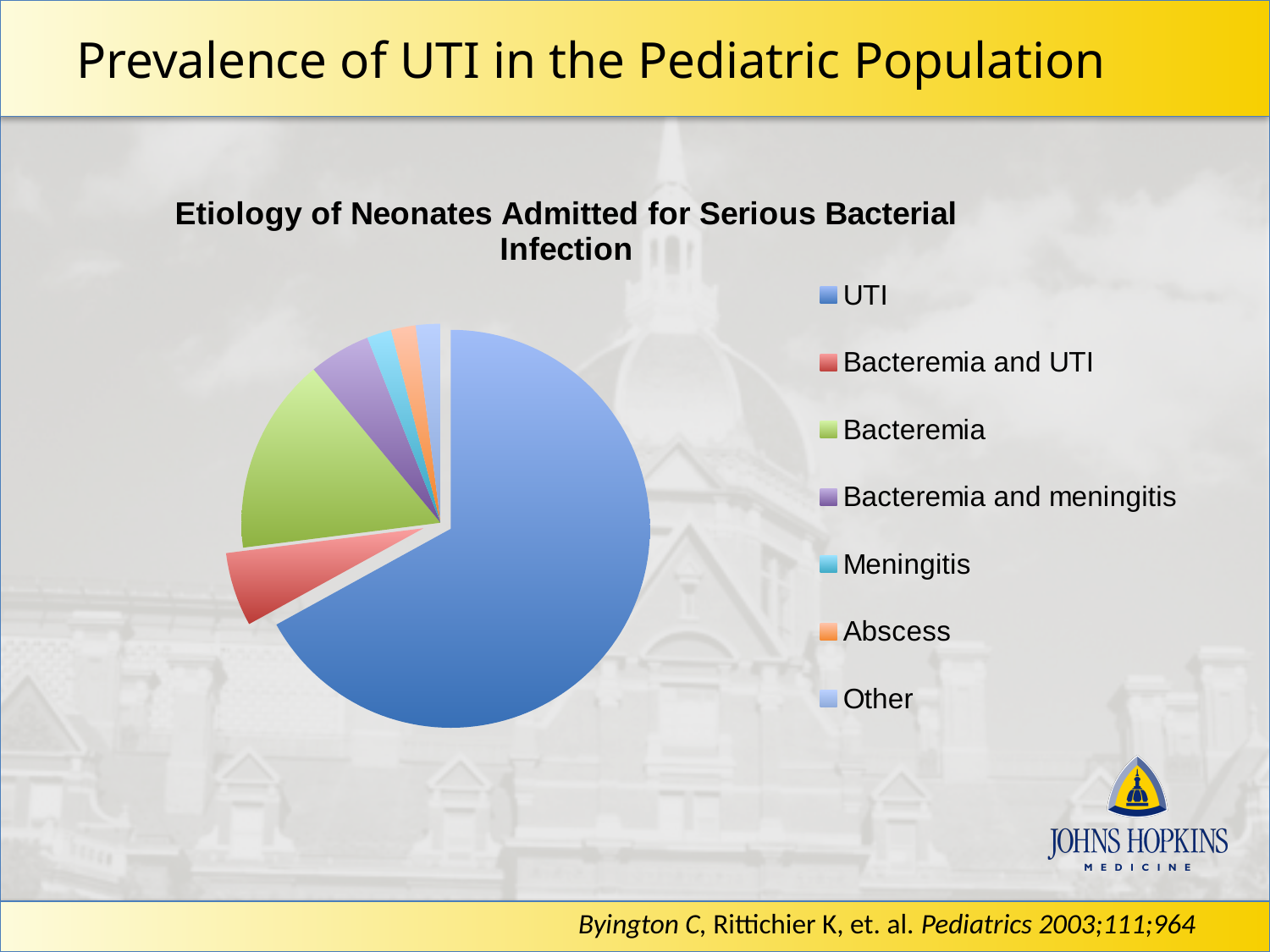
Which category has the largest slice of the pie? UTI What kind of chart is shown on the slide? pie chart Which is larger, the slice for Bacteremia or the slice for Bacteremia and UTI? Bacteremia What is the title of the chart? Etiology of Neonates Admitted for Serious Bacterial Infection Which is larger, the slice for UTI or the slice for Bacteremia? UTI How many entries does the legend list? 7 Which is larger, the slice for Bacteremia or the slice for Bacteremia and meningitis? Bacteremia Is the share of the pie for UTI greater or less than 50%? greater Which category is shown in green in the pie chart? Bacteremia How many categories (slices) does the pie chart have? 7 Which category is listed last in the legend? Other